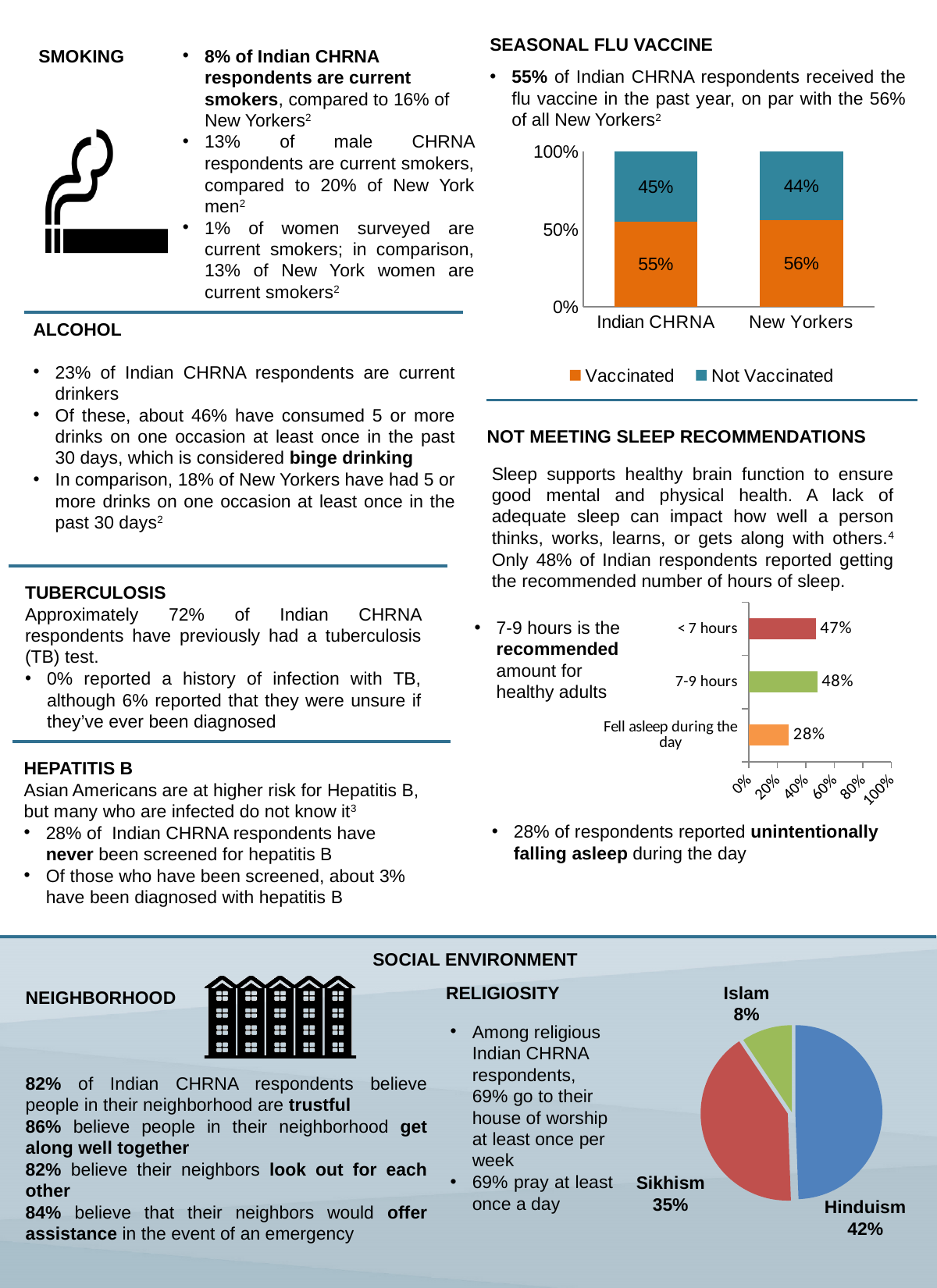
In the sleep chart under Not Meeting Sleep Recommendations, what percentage of respondents reported 7-9 hours of sleep? 48% What type of chart is the sleep chart under Not Meeting Sleep Recommendations? Bar chart In the sleep chart under Not Meeting Sleep Recommendations, what is the difference between the < 7 hours value and the Fell asleep during the day value? 19% In the Religiosity pie chart, which religion has the largest slice? Hinduism In the Seasonal Flu Vaccine chart, what percentage of Indian CHRNA respondents were vaccinated? 55% In the Seasonal Flu Vaccine chart, what colour represents the Vaccinated series? Orange In the Seasonal Flu Vaccine chart, which group has the larger vaccinated share, Indian CHRNA or New Yorkers? New Yorkers In the sleep chart under Not Meeting Sleep Recommendations, which category has the lowest value? Fell asleep during the day In the Seasonal Flu Vaccine chart, what is the total of the stacked bar for Indian CHRNA? 100% In the Religiosity pie chart, what share is Sikhism? 35% In the Seasonal Flu Vaccine chart, how many series does the legend list? 2 In the Seasonal Flu Vaccine chart, what percentage of New Yorkers were not vaccinated? 44%